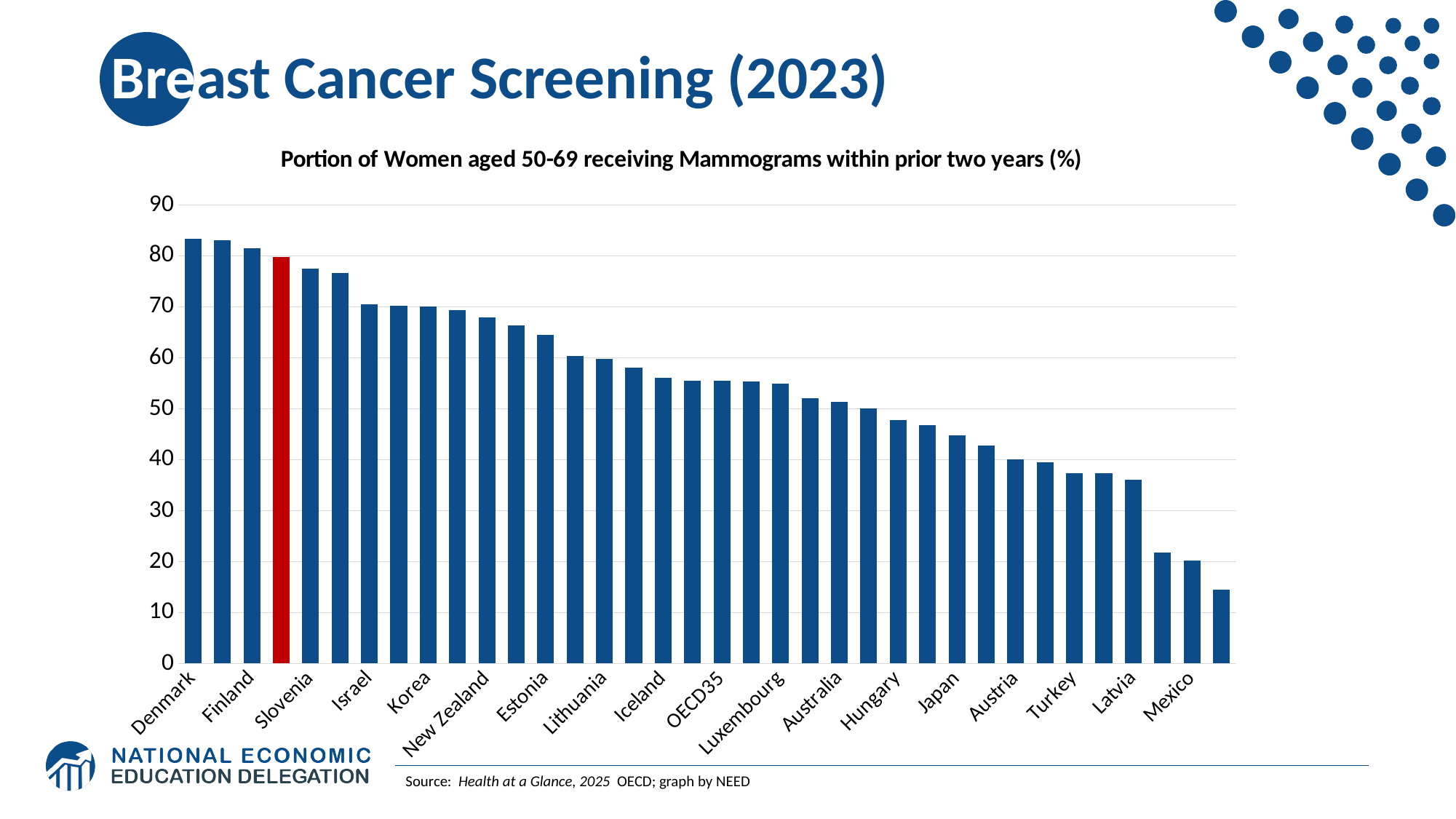
How many bars are coloured red? 1 Is the value for Slovenia greater or less than 70? greater What kind of chart is shown on the slide? Bar chart Is the value for Denmark greater or less than 80? greater What is the title of the chart? Portion of Women aged 50-69 receiving Mammograms within prior two years (%) Do the values rise or fall moving from left to right along the x axis? Fall Is the value for Hungary greater or less than 50? less Which has the larger value, Japan or Hungary? Hungary Which has the larger value, Estonia or Lithuania? Estonia